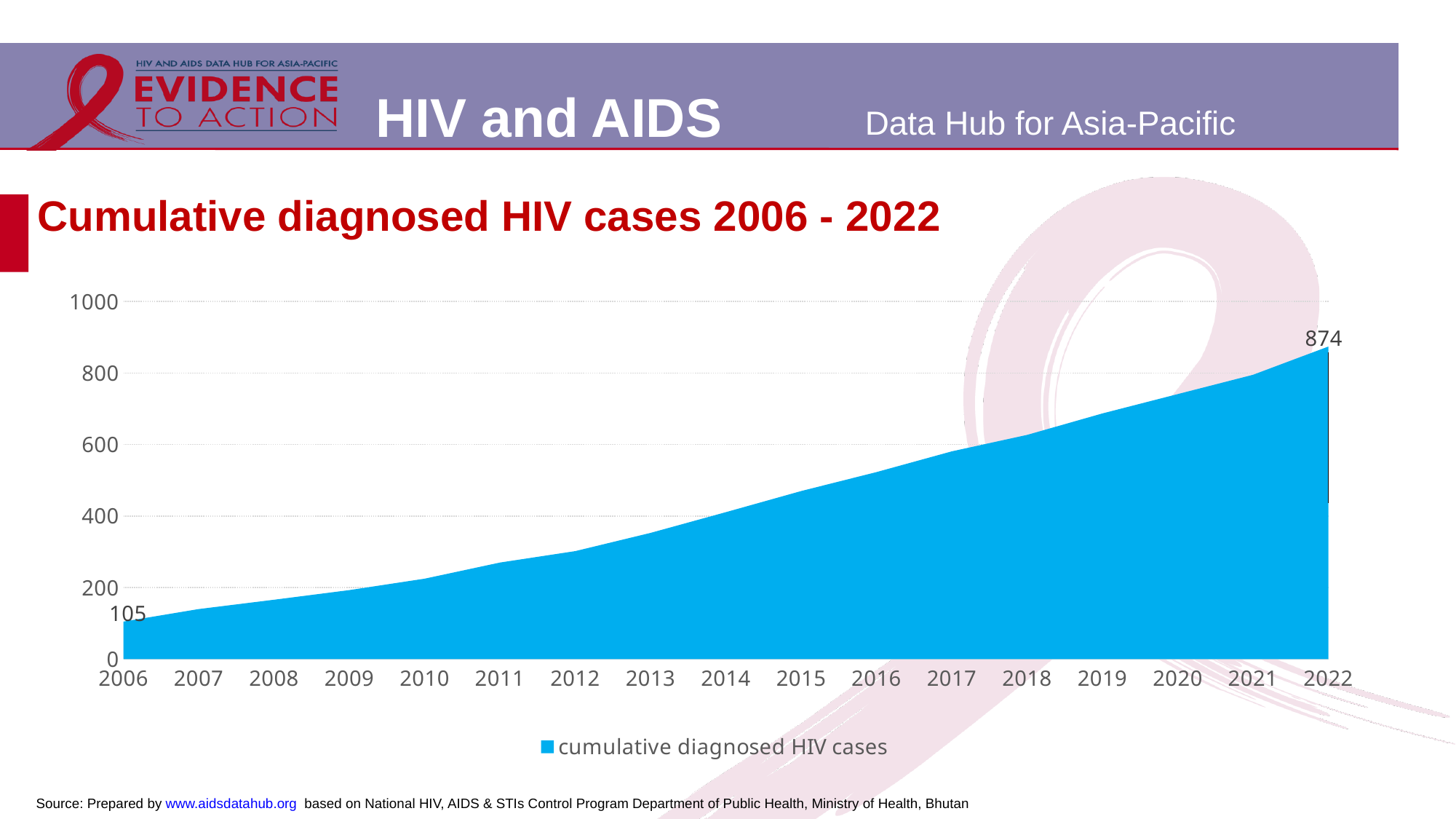
Is the value for 2012 greater or less than 400? less How many series does the legend list? 1 Which year has the lowest cumulative diagnosed HIV cases? 2006 Do the cumulative diagnosed HIV cases rise or fall from 2006 to 2022? rise What is the value for 2006 in the cumulative diagnosed HIV cases chart? 105 Is the value for 2016 greater or less than 400? greater Is the value for 2020 greater or less than 600? greater Which year has more cumulative diagnosed HIV cases, 2010 or 2018? 2018 What is the difference between the cumulative diagnosed HIV cases in 2022 and in 2006? 769 Which year has the highest cumulative diagnosed HIV cases? 2022 How many years are shown on the x axis of the chart? 17 What is the value for 2022 in the cumulative diagnosed HIV cases chart? 874